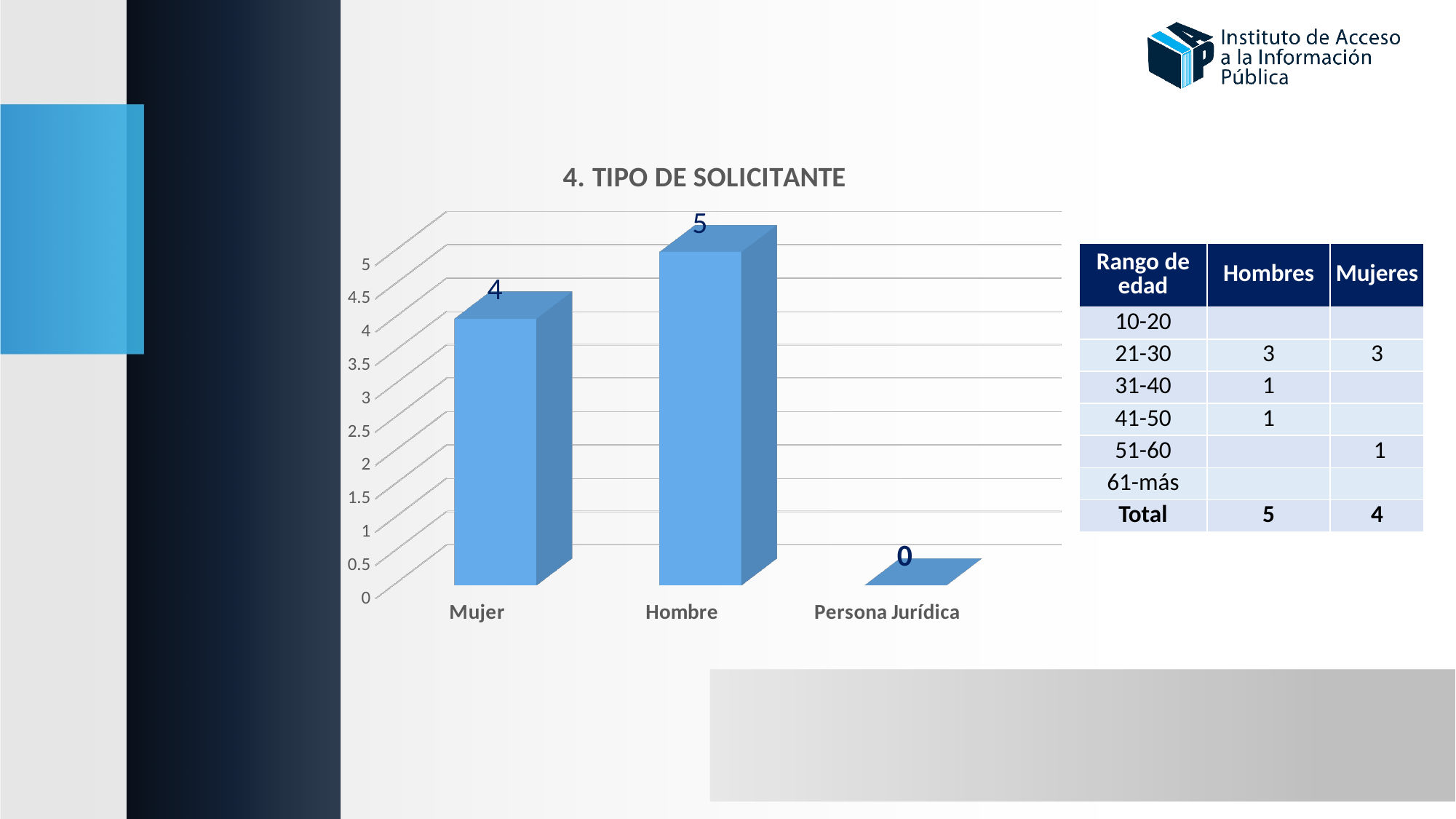
Which is larger, the value for Mujer or the value for Hombre? Hombre Which category has the lowest value in the chart? Persona Jurídica Which category has the highest value in the chart? Hombre How many categories are shown in the chart? 3 What is the maximum value shown on the vertical axis of the chart? 5 What kind of chart is shown on the slide? Bar chart What is the difference between the values for Hombre and Mujer? 1 What is the value for Persona Jurídica in the chart? 0 What is the value for Mujer in the chart? 4 Is the value for Mujer greater or less than 3? greater What is the title of the chart? 4. TIPO DE SOLICITANTE What is the value for Hombre in the chart? 5